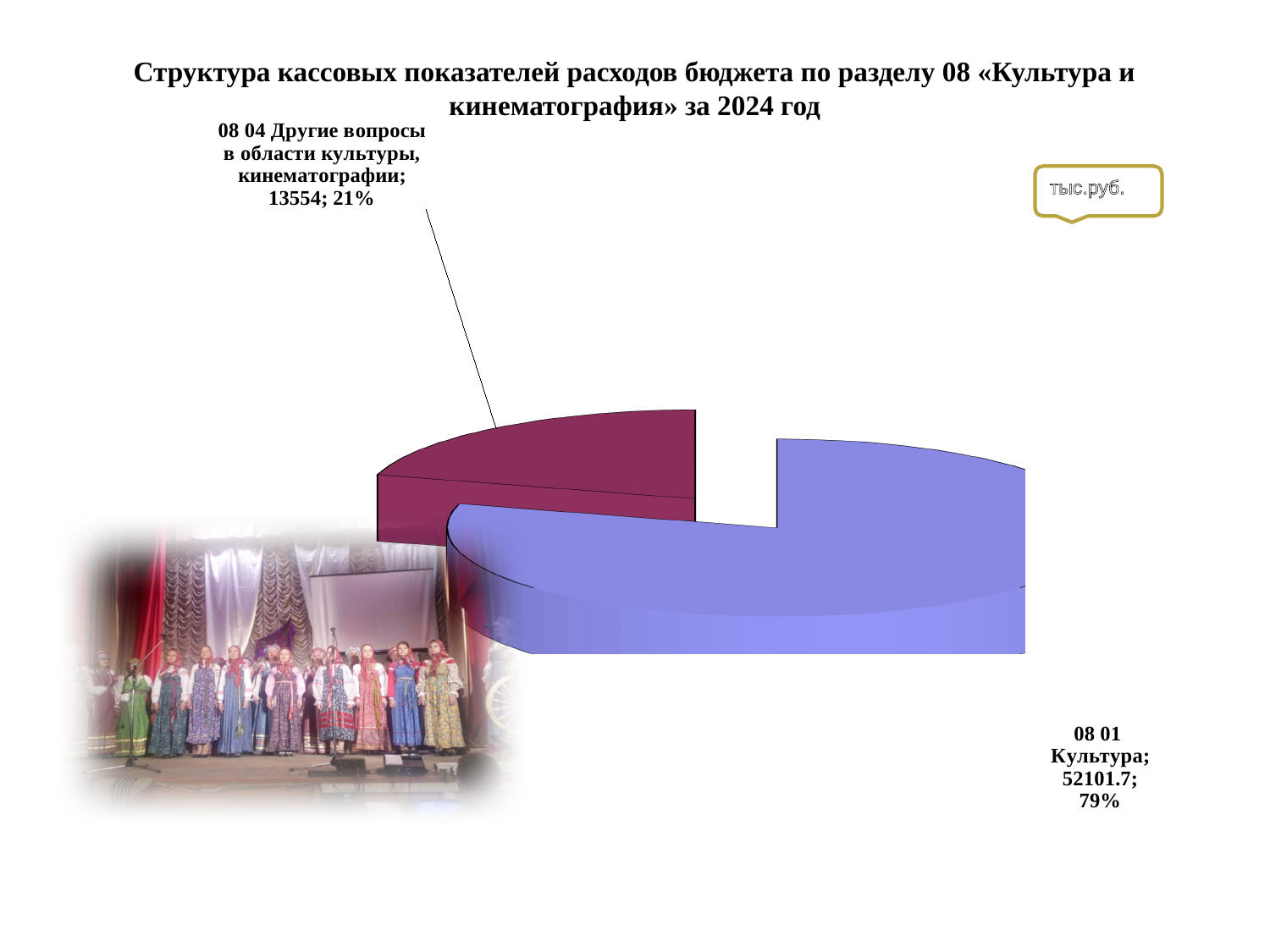
What unit of measurement is indicated on the slide for the chart values? тыс.руб. What is the value for "08 04 Другие вопросы в области культуры, кинематографии"? 13554 Which category has the largest slice of the pie? 08 01 Культура Which category has the smallest slice of the pie? 08 04 Другие вопросы в области культуры, кинематографии How many slices does the pie chart have? 2 What share of the pie does "08 04 Другие вопросы в области культуры, кинематографии" represent? 21% What is the difference between the values for "08 01 Культура" and "08 04 Другие вопросы в области культуры, кинематографии"? 38547.7 What colour is the slice for "08 01 Культура"? blue What share of the pie does "08 01 Культура" represent? 79% What kind of chart is shown on the slide? pie chart What is the value for "08 01 Культура"? 52101.7 Which is larger, the value for "08 01 Культура" or the value for "08 04 Другие вопросы в области культуры, кинематографии"? 08 01 Культура